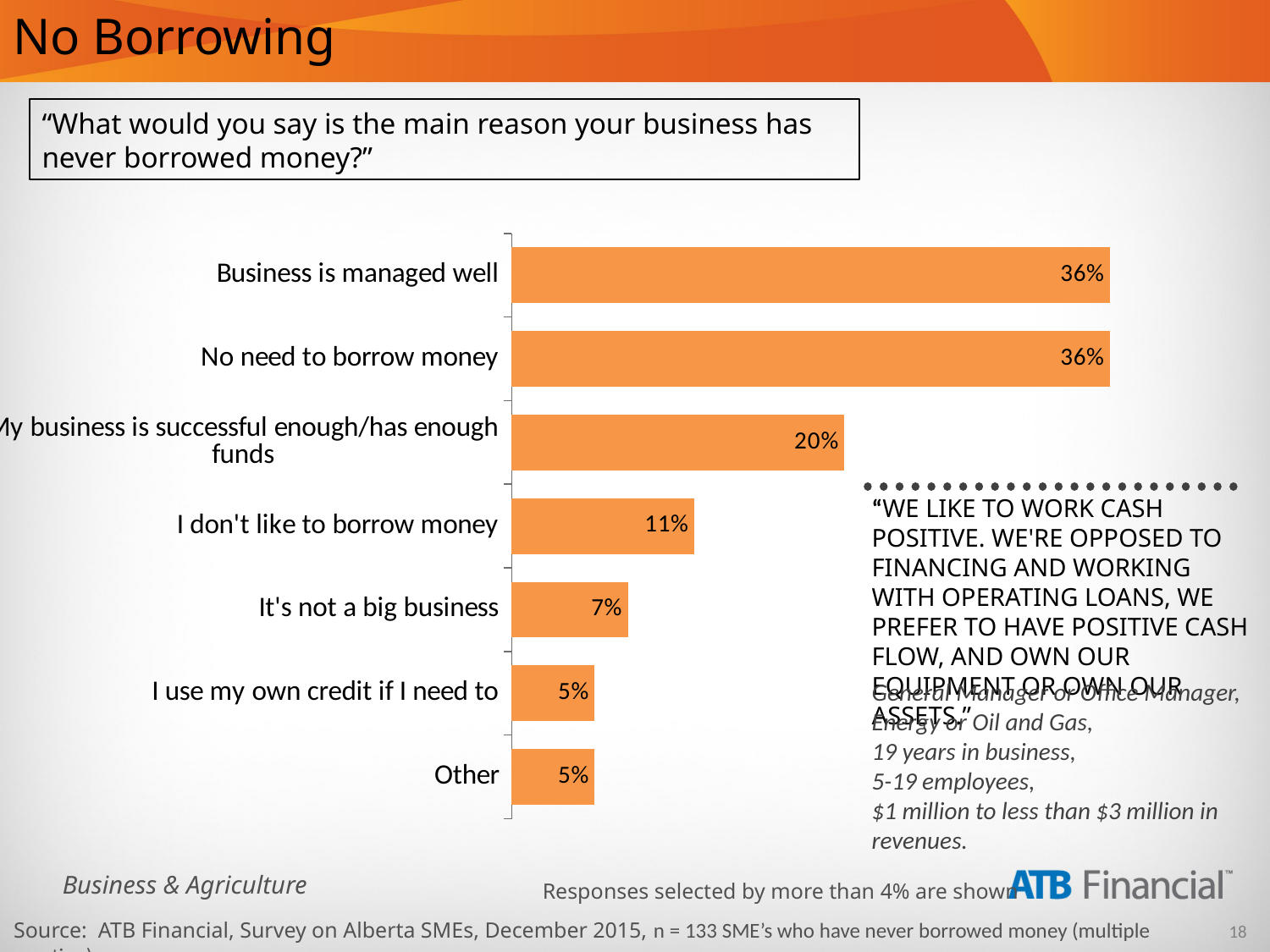
Which has a larger value: "It's not a big business" or "I don't like to borrow money"? I don't like to borrow money What is the difference between the value for "No need to borrow money" and the value for "I don't like to borrow money"? 25 percentage points What colour are the bars in the chart? Orange What is the value for "I use my own credit if I need to"? 5% How many reasons (categories) are shown on the chart? 7 What percentage is shown for "It's not a big business"? 7% What is the value for "My business is successful enough/has enough funds"? 20% What percentage is shown for the "Other" category? 5% What is the highest percentage shown on the chart? 36% What is the value shown for "I don't like to borrow money"? 11% What percentage of respondents said "Business is managed well" is the main reason their business has never borrowed money? 36% What type of chart is used on this slide? Bar chart